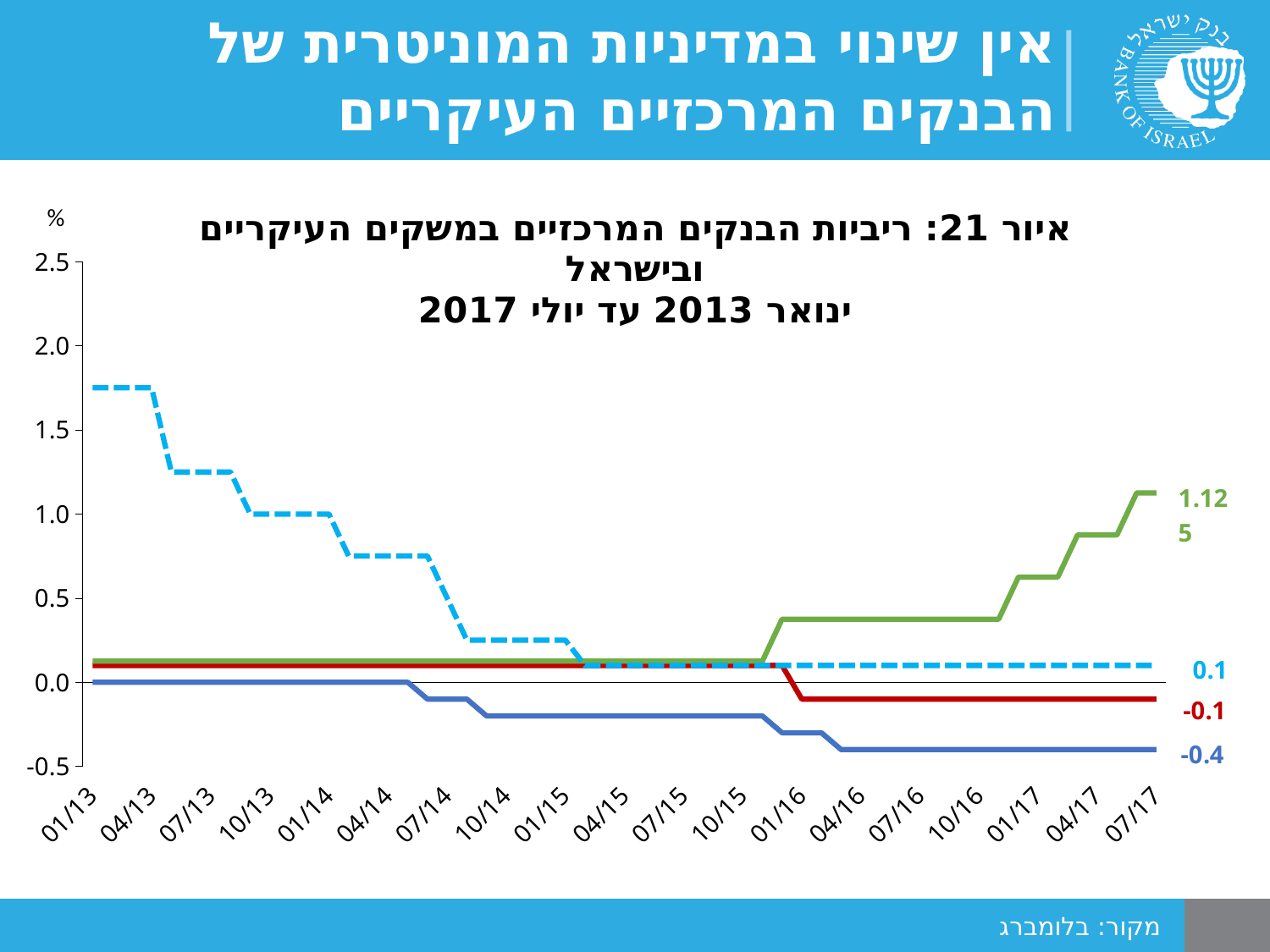
What is the value labelled at the end of the light blue dashed line (07/17)? 0.1 How many lines are plotted on the chart? 4 What is the value labelled at the end of the dark blue line (07/17)? -0.4 What is the value labelled at the end of the green line (07/17)? 1.125 What is the value labelled at the end of the red line (07/17)? -0.1 Does the light blue dashed line rise or fall over the period from 01/13 to 07/17? fall Which line has the highest value at 07/17? the green line Which line has the lowest value at 07/17? the dark blue line Is the value of the light blue dashed line at 01/13 greater or less than 1.5? greater What unit is shown on the y axis? % What is the difference between the end values of the green line and the dark blue line? 1.525 What type of chart is shown on the slide? line chart